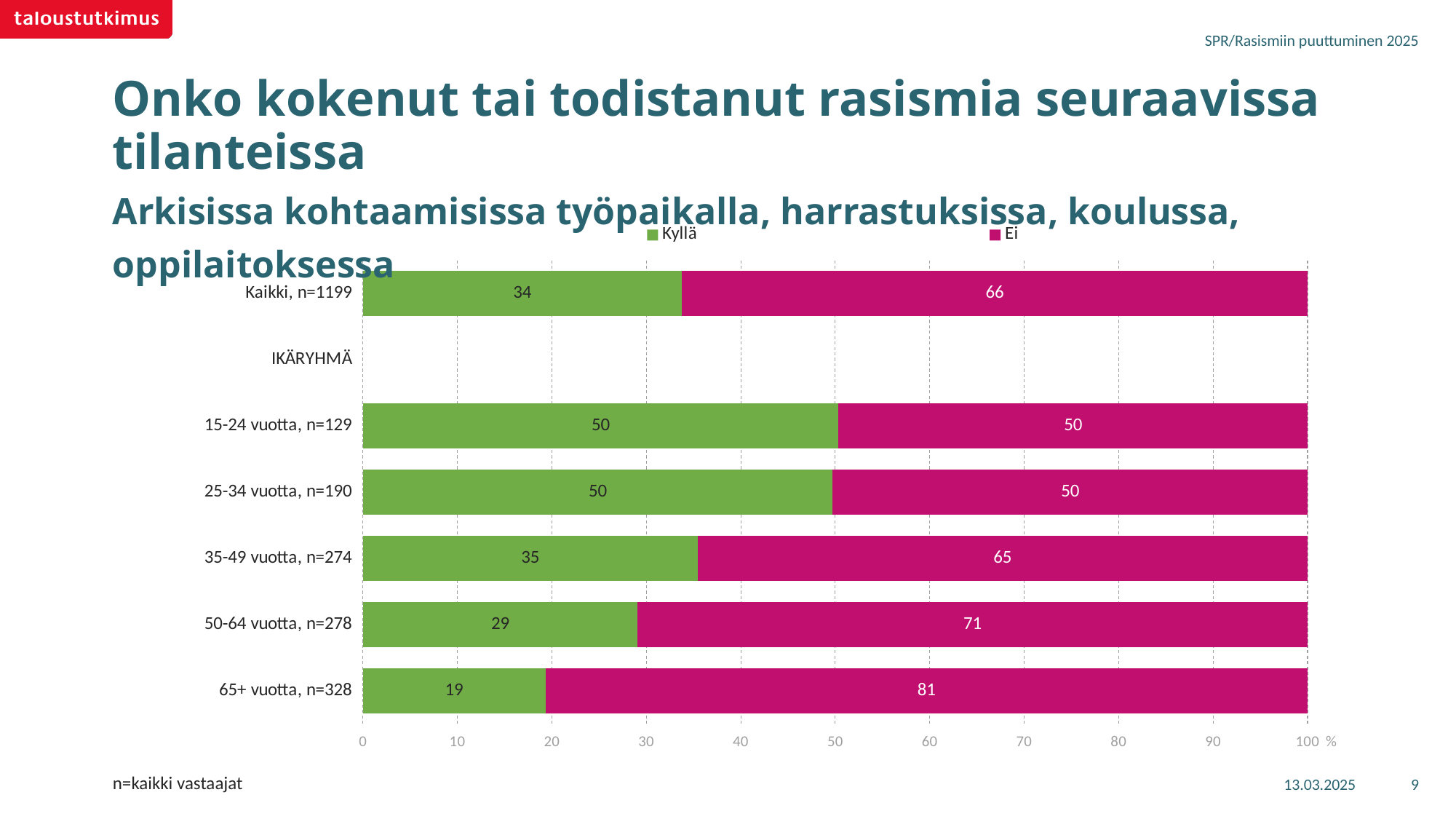
Which category has the highest Ei value? 65+ vuotta, n=328 Which age group has the lowest Kyllä value? 65+ vuotta, n=328 How many bars with data are plotted in the chart? 6 What kind of chart is shown on the slide? Stacked bar chart What is the Kyllä value for Kaikki, n=1199? 34 What is the total of the stacked bar for 15-24 vuotta, n=129? 100 Which colour represents the Ei series in the chart? Pink (magenta) What is the Ei value for 65+ vuotta, n=328? 81 What is the difference between the Ei and Kyllä values for 35-49 vuotta, n=274? 30 Is the Kyllä value larger for 25-34 vuotta, n=190 or for 50-64 vuotta, n=278? 25-34 vuotta, n=190 How many series does the legend list? 2 What is the Kyllä value for 50-64 vuotta, n=278? 29